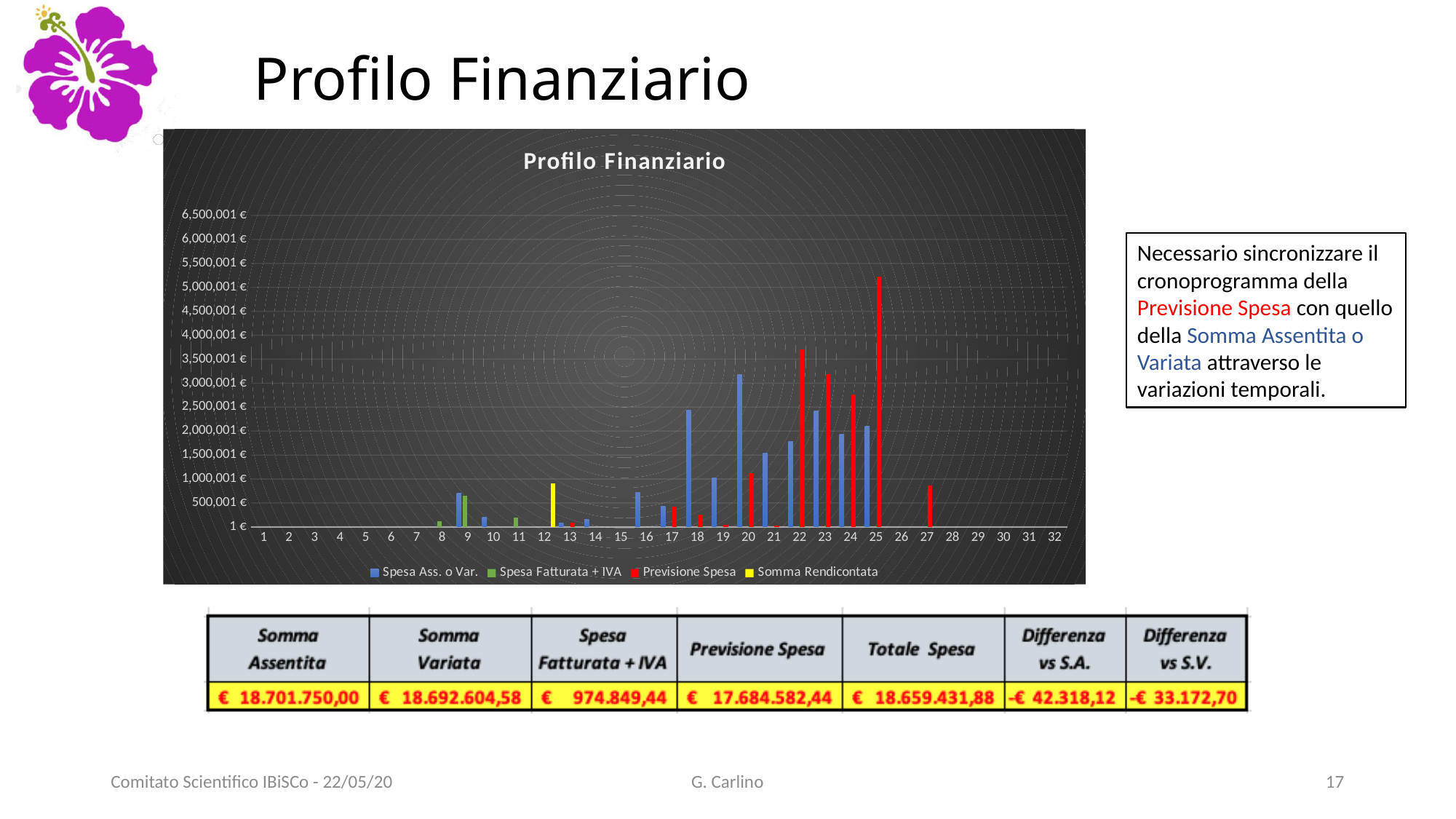
Is the Previsione Spesa value for period 27 greater or less than 500,001 €? greater What kind of chart is shown on the slide? bar chart Is the Somma Rendicontata value for period 12 greater or less than 1,000,001 €? less Is the Spesa Ass. o Var. value for period 20 greater or less than 3,000,001 €? greater What colour represents the Previsione Spesa series in the chart? red For the Spesa Ass. o Var. series, which period has the larger value: 18 or 19? 18 How many series does the legend of the Profilo Finanziario chart list? 4 How many periods are labelled along the x axis of the Profilo Finanziario chart? 32 In period 22, which is larger: Previsione Spesa or Spesa Ass. o Var.? Previsione Spesa In which period does the Spesa Ass. o Var. series reach its highest value? 20 In which period does the Previsione Spesa series reach its highest value? 25